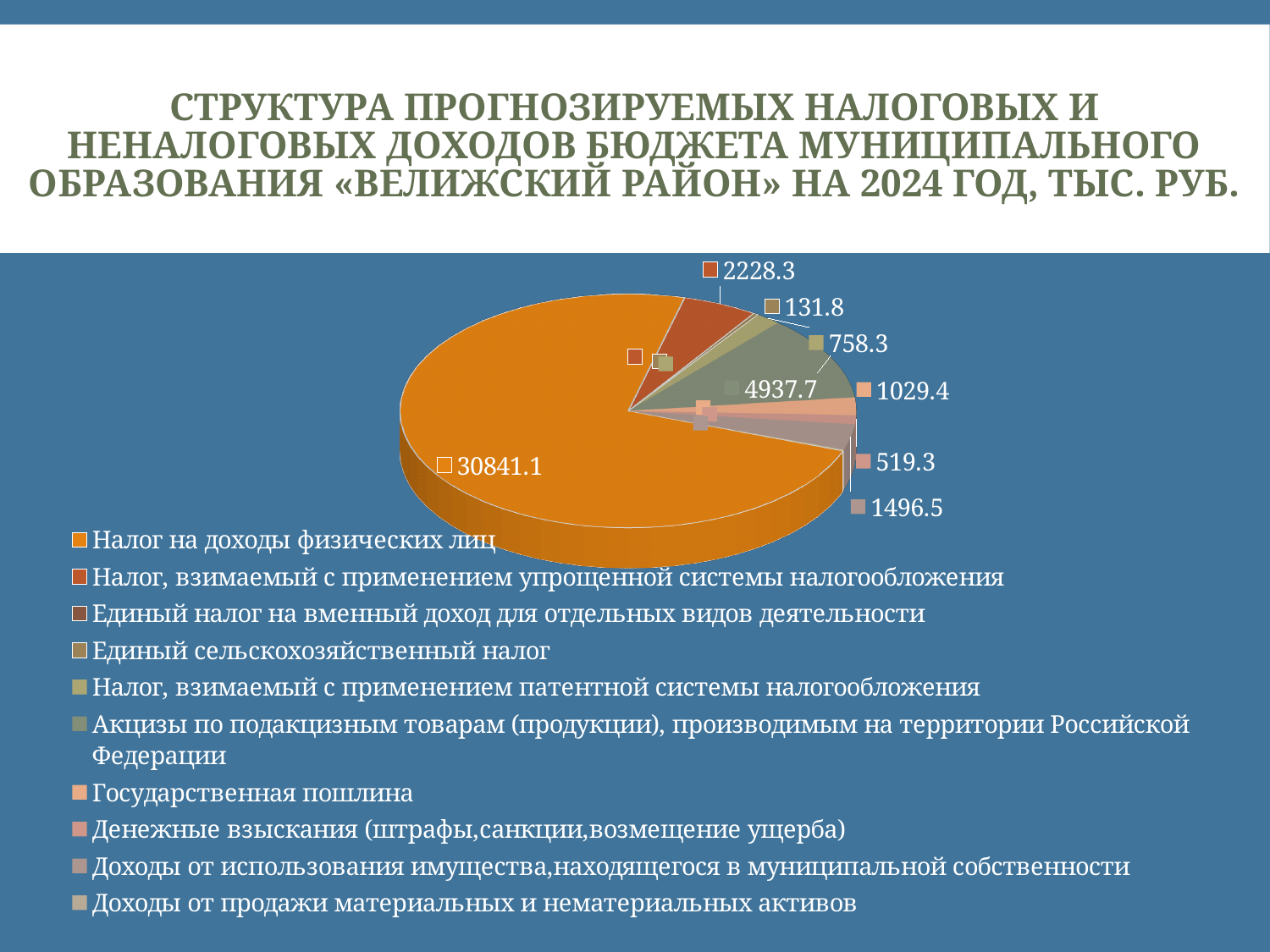
What is the value shown for Налог на доходы физических лиц? 30841.1 What is the value shown for Налог, взимаемый с применением упрощенной системы налогообложения? 2228.3 What type of chart is shown on the slide? Pie chart What is the value of the largest slice in the pie chart? 30841.1 Which category has the largest slice in the pie chart? Налог на доходы физических лиц How many categories does the legend list? 10 What is the smallest value printed as a data label on the pie chart? 131.8 What is the difference between the slice labelled 1029.4 and the slice labelled 519.3? 510.1 What is the value shown for Акцизы по подакцизным товарам (продукции), производимым на территории Российской Федерации? 4937.7 Which is larger, the slice labelled 2228.3 or the slice labelled 1496.5? 2228.3 What is the difference between the slice labelled 2228.3 and the slice labelled 1496.5? 731.8 In what units are the values on the chart expressed, according to the slide title? тыс. руб.